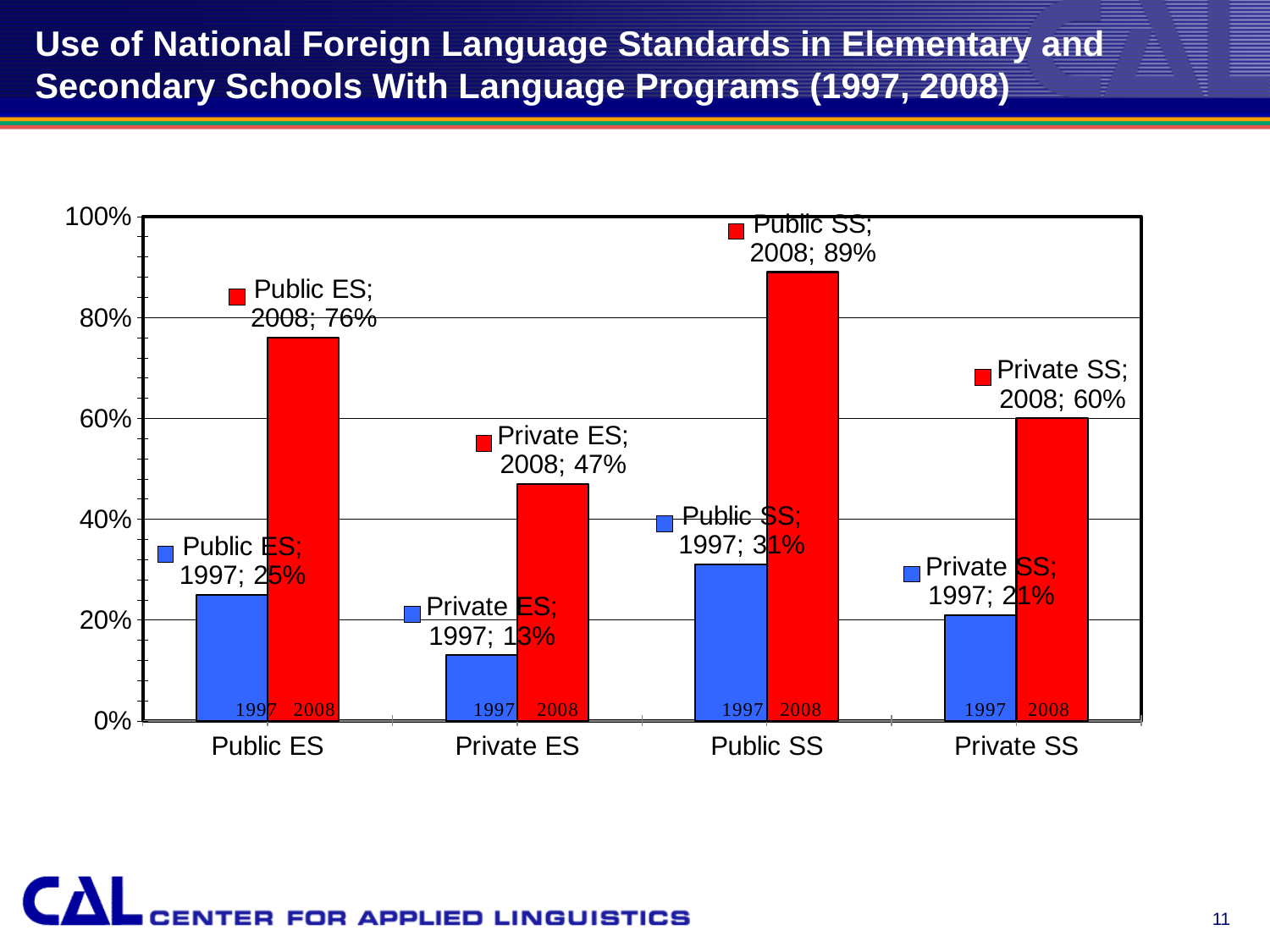
Which is larger: the 1997 value for Public SS or the 1997 value for Public ES? Public SS What is the difference between the 2008 values for Public SS and Private SS? 29 percentage points How many years are compared for each school type? 2 What was the value for Public ES in 2008? 76% How many school types are shown on the x axis? 4 What was the value for Public SS in 2008? 89% Which school type had the highest value in 2008? Public SS What is the difference between the 2008 and 1997 values for Public ES? 51 percentage points What was the value for Private ES in 1997? 13% Which school type had the lowest value in 1997? Private ES What kind of chart is shown on the slide? Bar chart What was the value for Private SS in 1997? 21%